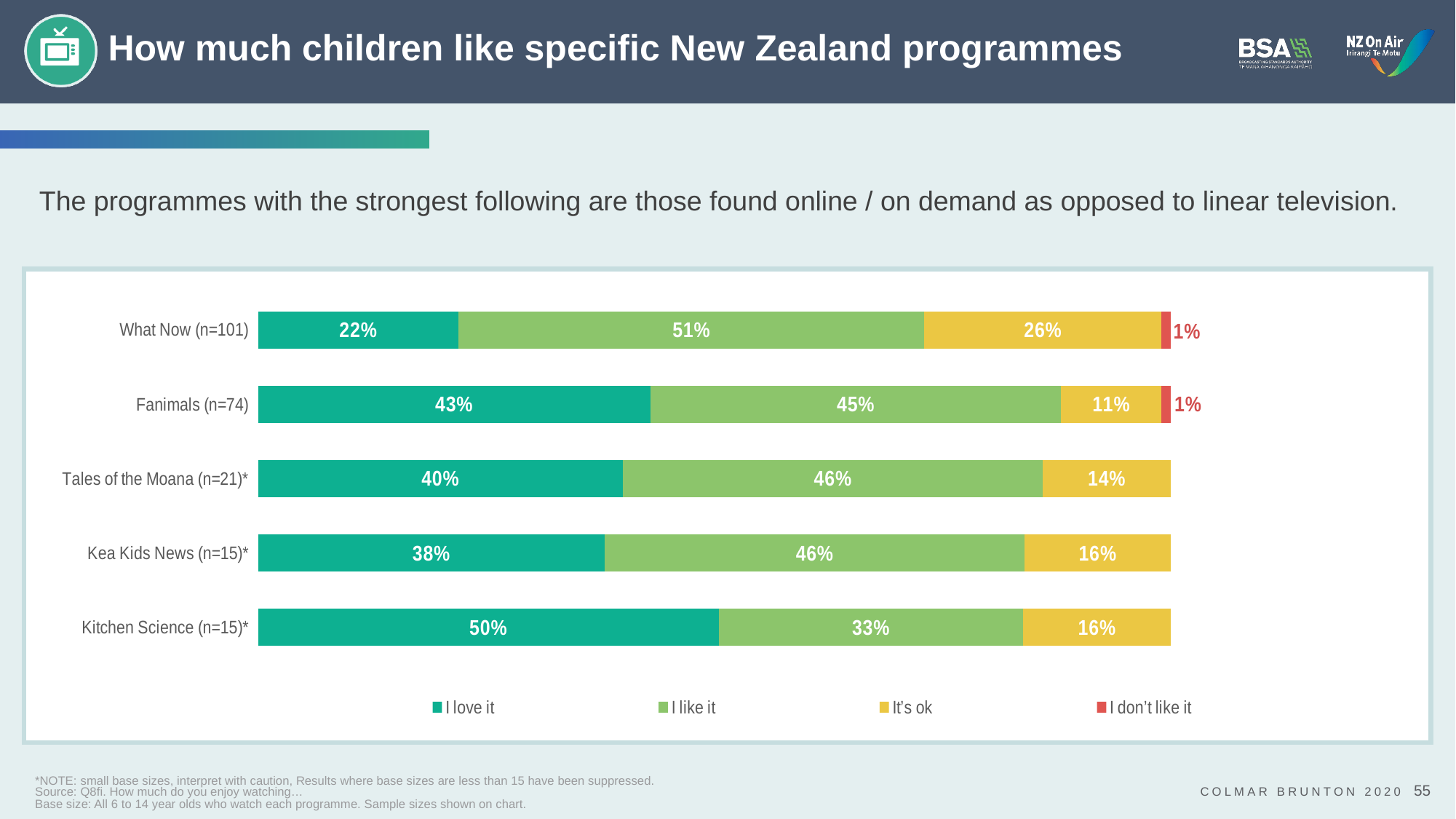
Which is larger: the "I love it" value for Tales of the Moana or for Kea Kids News? Tales of the Moana How many series does the legend list? 4 What type of chart is shown on the slide? Stacked bar chart What is the total of the labelled segments for the Kitchen Science bar? 99% How many programmes are shown in the chart? 5 Which programme has the highest "It's ok" percentage? What Now What percentage of children said "I love it" for Kitchen Science? 50% What percentage of children said "I like it" for What Now? 51% What is the difference in percentage points between the "I love it" values for Fanimals and What Now? 21 percentage points What percentage of children said "It's ok" for Fanimals? 11% Which programme has the highest "I love it" percentage? Kitchen Science Which programme has the lowest "I love it" percentage? What Now